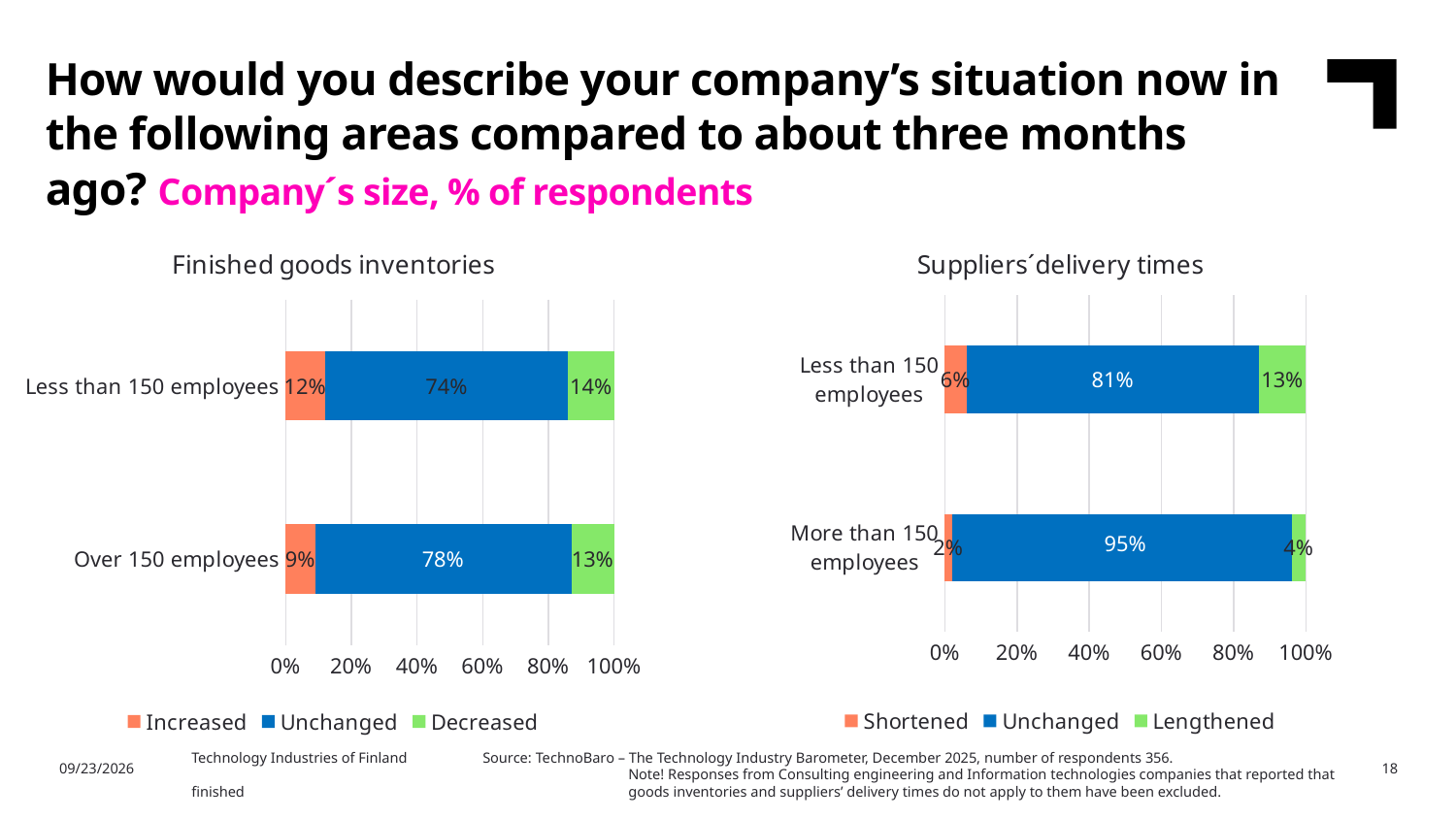
What are the legend entries of the Suppliers´delivery times chart? Shortened, Unchanged, Lengthened In the Suppliers´delivery times chart, what percentage of companies with more than 150 employees reported Unchanged? 95% How many categories are shown in the Finished goods inventories chart? 2 In the Finished goods inventories chart, what percentage of companies with over 150 employees reported Increased? 9% In the Finished goods inventories chart, what is the difference between the Decreased share for less than 150 employees and for over 150 employees? 1 percentage point How many series does the legend of the Suppliers´delivery times chart list? 3 In the Suppliers´delivery times chart, what percentage of companies with less than 150 employees reported Lengthened? 13% What kind of chart is the Finished goods inventories chart? Stacked bar chart In the Suppliers´delivery times chart, which size group has the higher Unchanged share? More than 150 employees In the Finished goods inventories chart, what is the total of the stacked bar for over 150 employees? 100% In the Finished goods inventories chart, what percentage of companies with less than 150 employees reported Unchanged? 74% In the Suppliers´delivery times chart, what is the difference between the Shortened share for less than 150 employees and for more than 150 employees? 4 percentage points